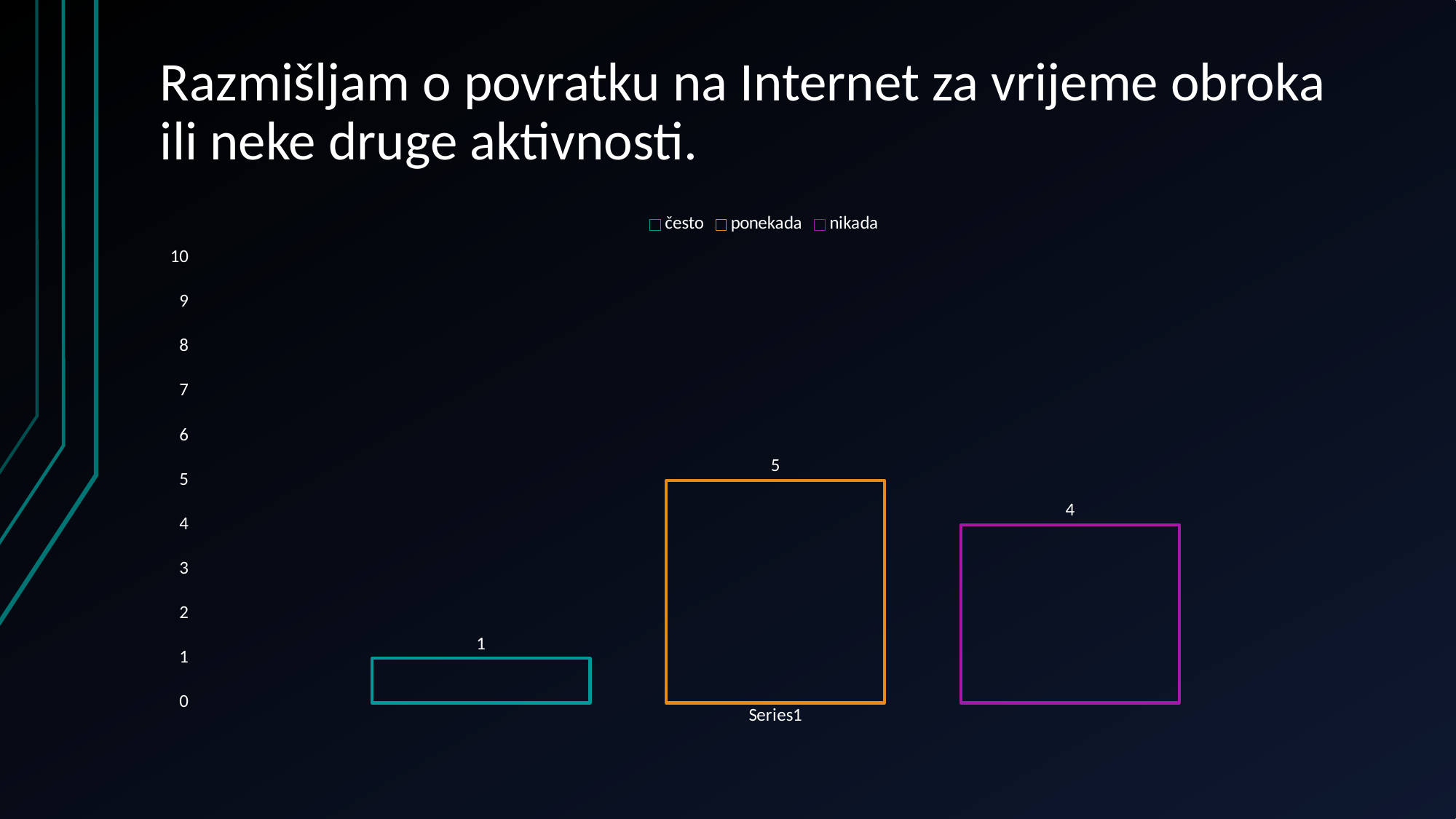
What is the value for "nikada"? 4 What is the value for "često"? 1 What is the difference between the values for "ponekada" and "nikada"? 1 What is the value for "ponekada"? 5 What is the total of the three bar values? 10 How many series does the legend list? 3 What kind of chart is shown on the slide? bar chart Which is larger, the value for "nikada" or the value for "često"? nikada What is the highest value shown on the vertical axis? 10 Which series has the highest value? ponekada Which series has the lowest value? često What is the difference between the values for "ponekada" and "često"? 4